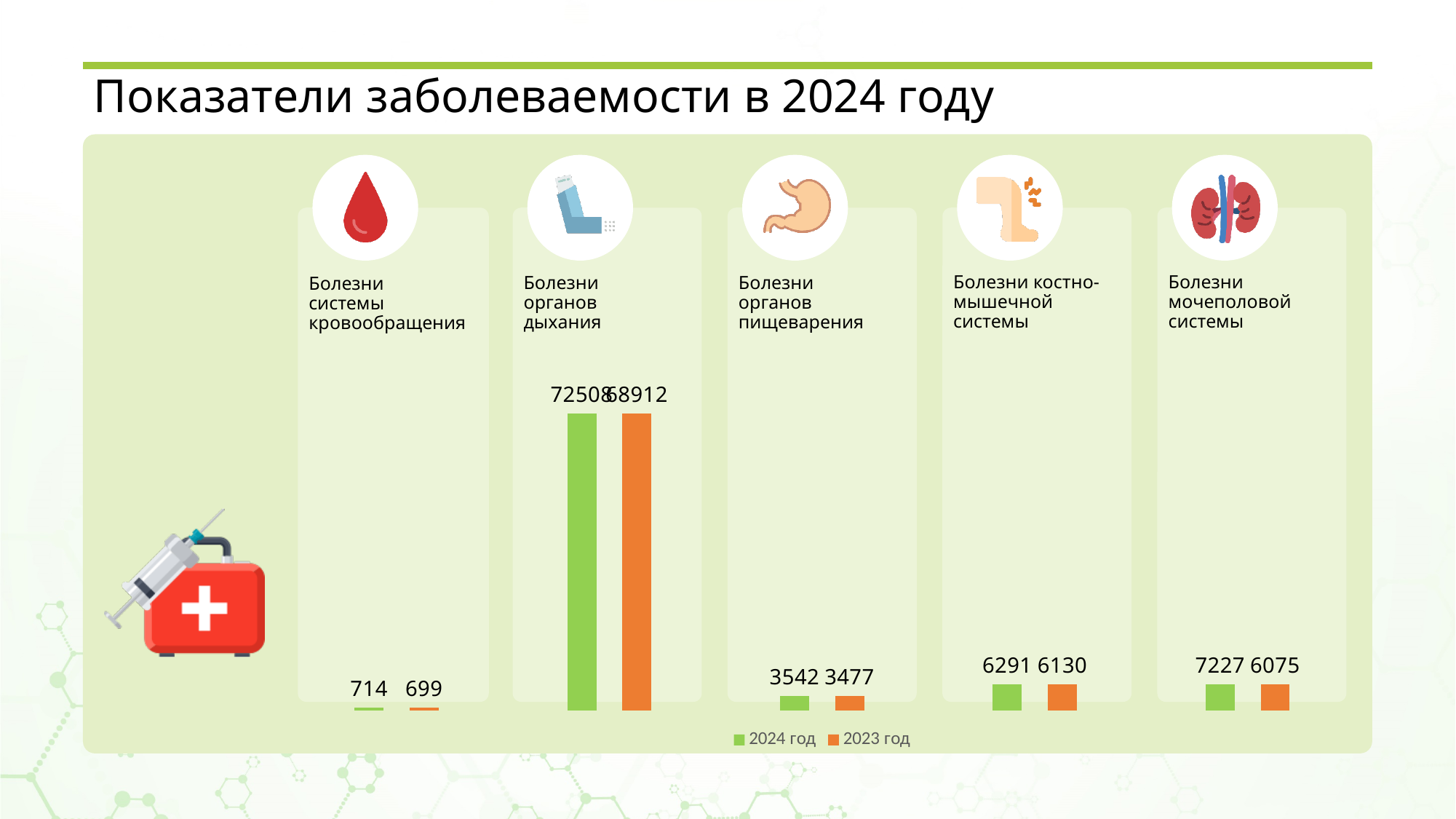
Which category has the highest 2024 год value? Болезни органов дыхания What is the 2024 год value for Болезни системы кровообращения? 714 How many series does the legend list? 2 For Болезни органов пищеварения, which series has the larger value, 2024 год or 2023 год? 2024 год What is the difference between the 2024 год and 2023 год values for Болезни мочеполовой системы? 1152 What is the 2023 год value for Болезни органов пищеварения? 3477 Which category has the lowest 2023 год value? Болезни системы кровообращения What is the difference between the 2024 год and 2023 год values for Болезни костно-мышечной системы? 161 How many disease categories are shown in the chart? 5 What kind of chart is shown on the slide? Bar chart What is the 2023 год value for Болезни костно-мышечной системы? 6130 What is the 2024 год value for Болезни мочеполовой системы? 7227